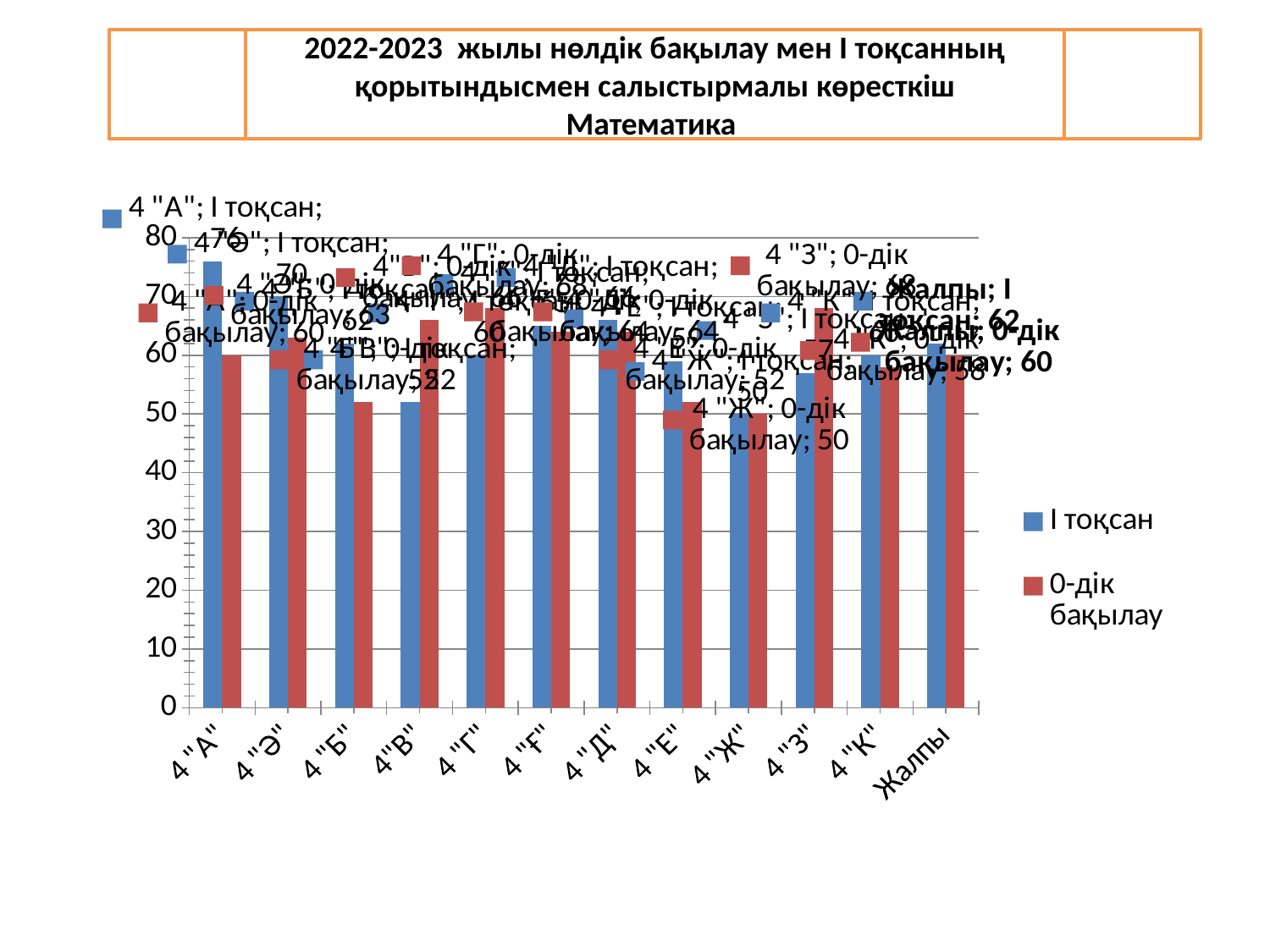
What is the I тоқсан value for 4 "А"? 76 How many series does the legend list? 2 What is the I тоқсан value for Жалпы? 62 What kind of chart is shown on the slide? bar chart Which category has the highest I тоқсан value? 4 "А" What is the 0-дік бақылау value for 4 "А"? 60 How many categories are shown along the x axis? 12 Which category has the lowest I тоқсан value? 4 "Ж" Which colour represents the I тоқсан series? blue What is the 0-дік бақылау value for 4 "З"? 68 What is the difference between the I тоқсан and 0-дік бақылау values for Жалпы? 2